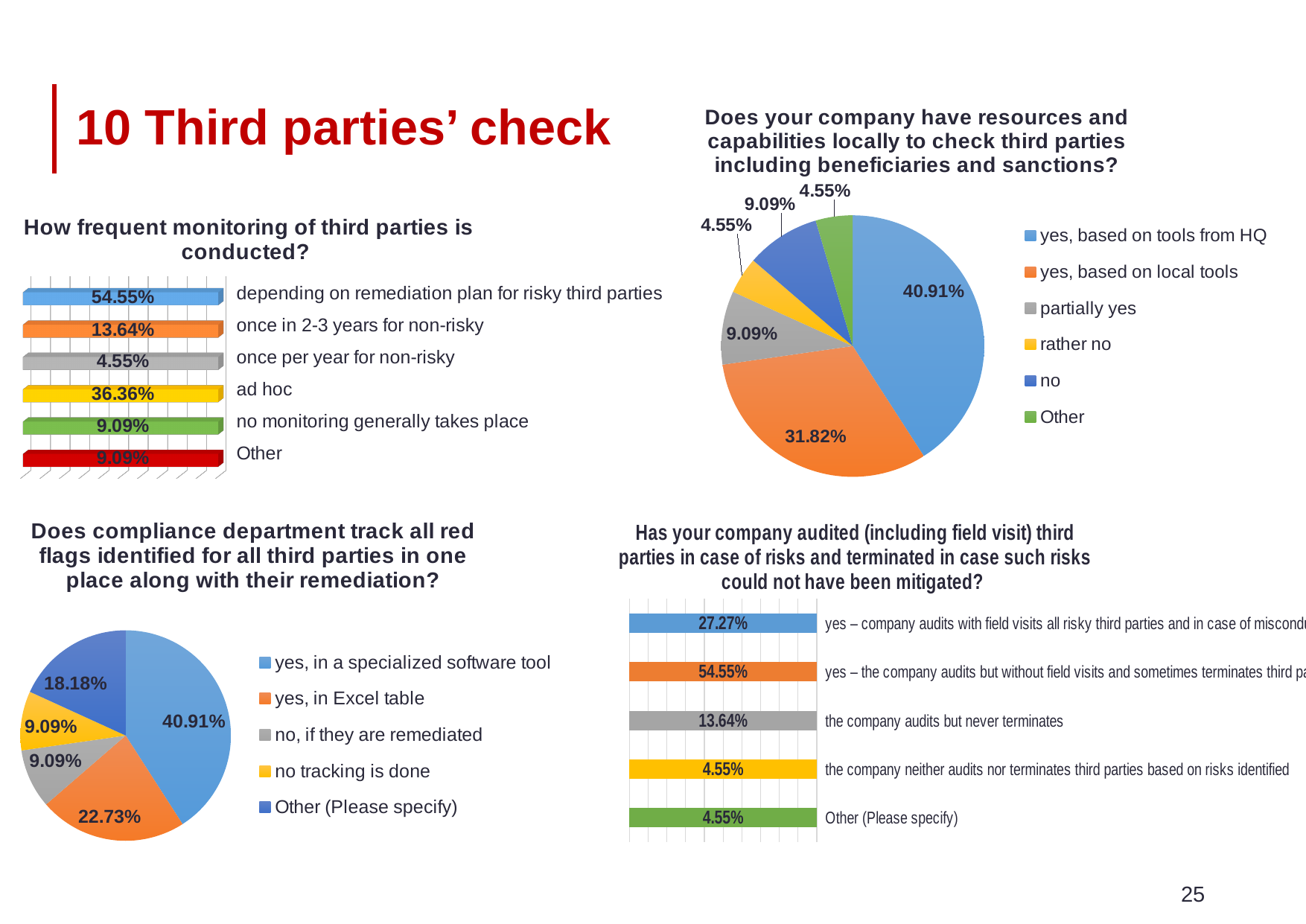
In the pie chart 'Does compliance department track all red flags identified for all third parties in one place along with their remediation?', what share is 'yes, in Excel table'? 22.73% In the chart 'Has your company audited (including field visit) third parties in case of risks and terminated in case such risks could not have been mitigated?', what is the value for 'the company audits but never terminates'? 13.64% What type of chart is used for 'How frequent monitoring of third parties is conducted?'? bar chart In the chart 'How frequent monitoring of third parties is conducted?', what is the value for 'ad hoc'? 36.36% In the pie chart 'Does your company have resources and capabilities locally to check third parties including beneficiaries and sanctions?', what share is 'yes, based on local tools'? 31.82% In the pie chart 'Does your company have resources and capabilities locally to check third parties including beneficiaries and sanctions?', which is larger: 'partially yes' or 'rather no'? partially yes In the pie chart 'Does your company have resources and capabilities locally to check third parties including beneficiaries and sanctions?', how many entries does the legend list? 6 In the pie chart 'Does compliance department track all red flags identified for all third parties in one place along with their remediation?', which category has the largest slice? yes, in a specialized software tool In the chart 'Has your company audited (including field visit) third parties in case of risks and terminated in case such risks could not have been mitigated?', how many bars are shown? 5 In the chart 'How frequent monitoring of third parties is conducted?', which category has the lowest value? once per year for non-risky In the chart 'How frequent monitoring of third parties is conducted?', which category has the highest value? depending on remediation plan for risky third parties In the chart 'How frequent monitoring of third parties is conducted?', what is the difference between 'depending on remediation plan for risky third parties' and 'ad hoc'? 18.19%